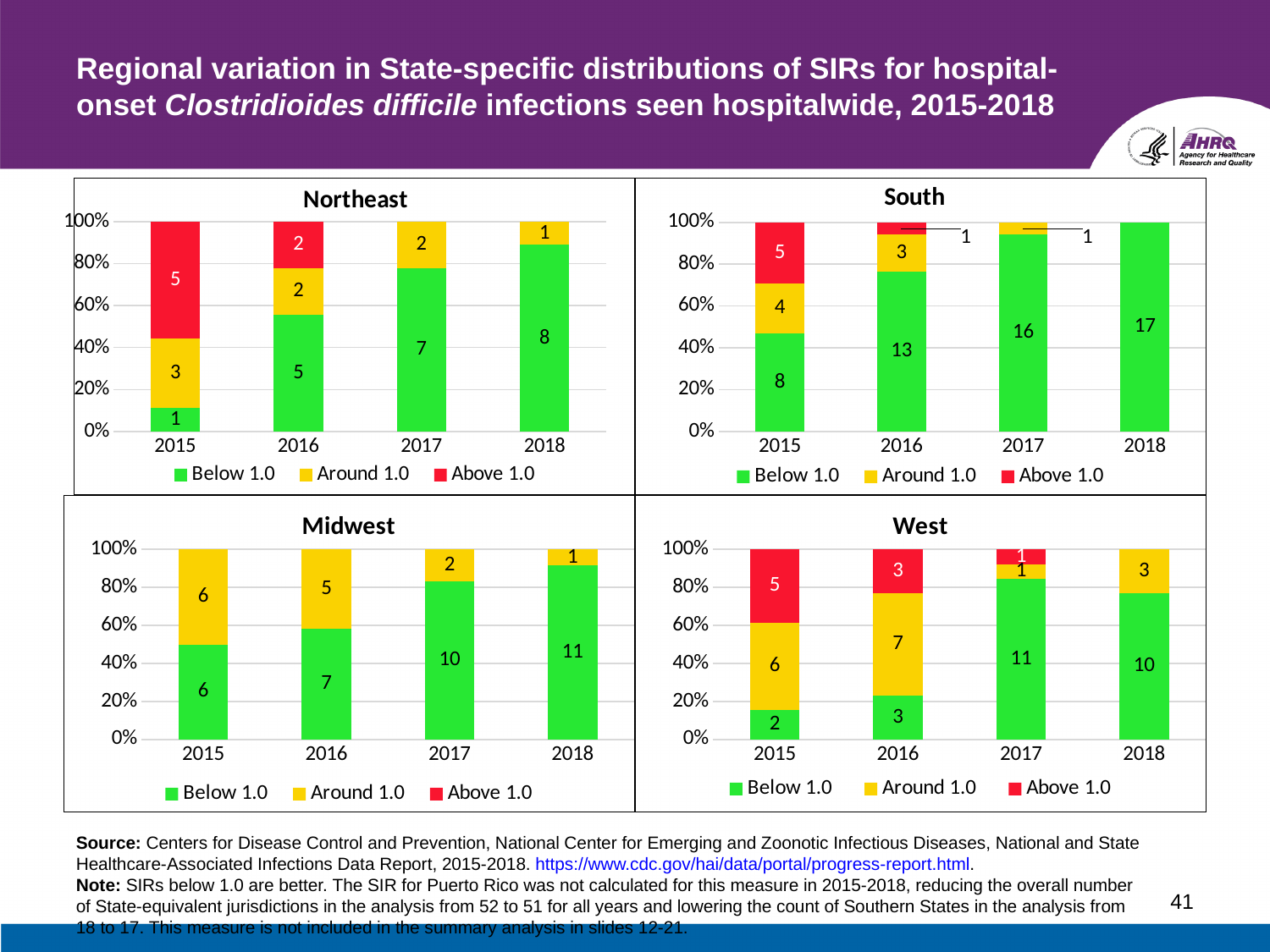
What type of chart is the West chart? Stacked bar chart In the Midwest chart, how many states were Around 1.0 in 2016? 5 In the West chart, what is the difference between the Around 1.0 count in 2016 and in 2017? 6 In the Northeast chart, how many states were Above 1.0 in 2015? 5 In the West chart, how many states were Below 1.0 in 2015? 2 In the Northeast chart, which year has the lowest count of states Below 1.0? 2015 In the South chart, what is the total number of states in the 2015 bar? 17 In the Midwest chart, is the Below 1.0 count larger in 2017 or in 2018? 2018 In the South chart, how many states were Below 1.0 in 2018? 17 In the Midwest chart, does the Below 1.0 count rise or fall from 2015 to 2018? Rise How many series does the legend of the Northeast chart list? 3 In the South chart, which year has the highest count of states Below 1.0? 2018